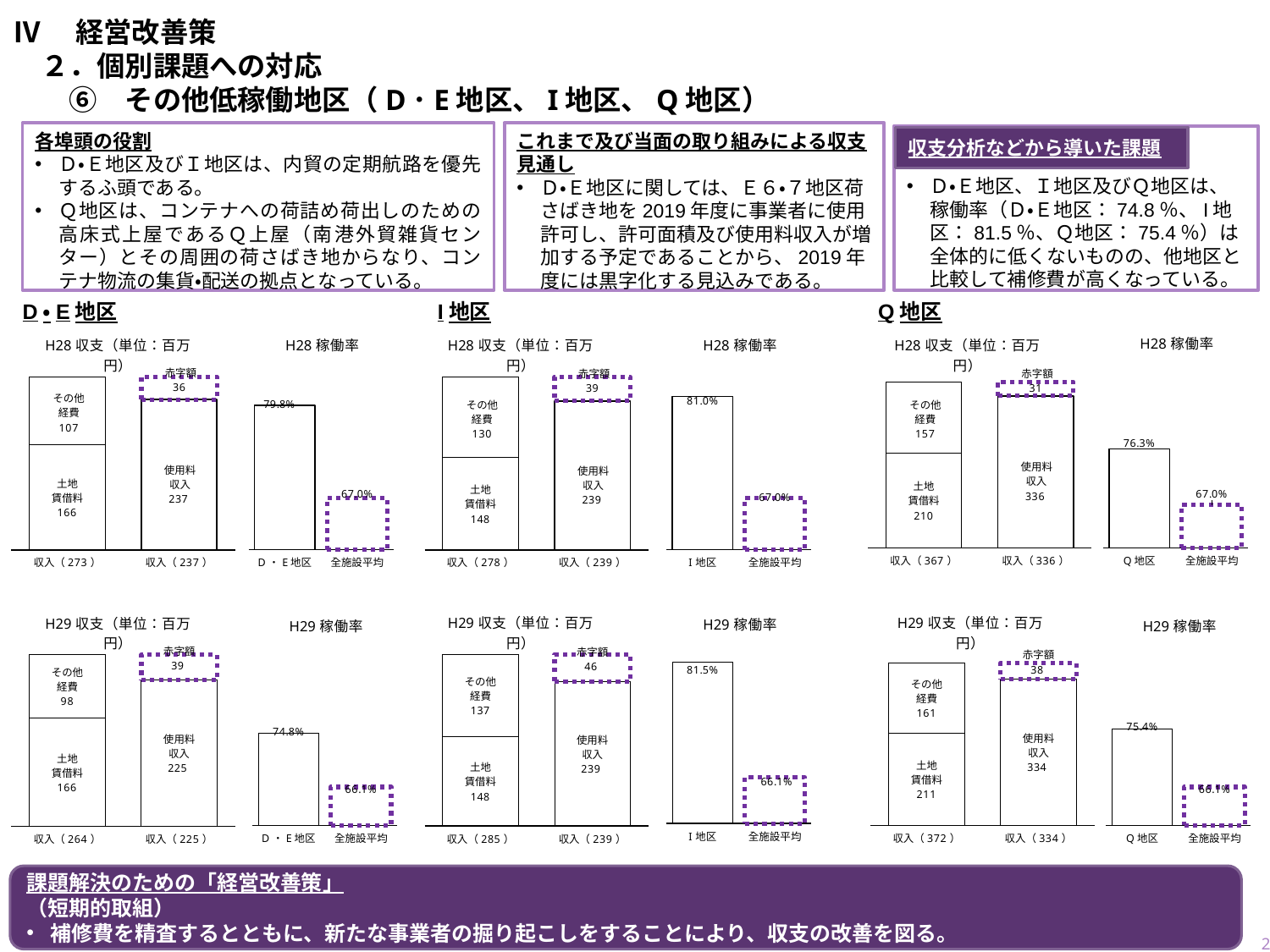
In the Q地区 H29 収支 chart, what is the value of 使用料収入? 334 In the Q地区 H28 稼働率 chart, which is higher, Q地区 or 全施設平均? Q地区 In the I地区 H29 稼働率 chart, what is the difference between I地区 and 全施設平均? 15.4% In the Q地区 H29 収支 chart, what is the total of the left stacked bar (その他経費 plus 土地賃借料)? 372 In the D・E地区 H28 稼働率 chart, what is the value for D・E地区? 79.8% In the I地区 H28 収支 chart, what is the value of 土地賃借料? 148 In the Q地区 H28 収支 chart, what is the difference between 土地賃借料 and その他経費? 53 In the D・E地区 H28 収支 chart, what is the total of the left stacked bar (その他経費 plus 土地賃借料)? 273 What kind of chart is the I地区 H28 稼働率 chart? bar chart In the I地区 H29 収支 chart, what is the 赤字額? 46 How many bars are shown in the D・E地区 H29 稼働率 chart? 2 In the D・E地区 H29 稼働率 chart, what is the value for 全施設平均? 66.1%